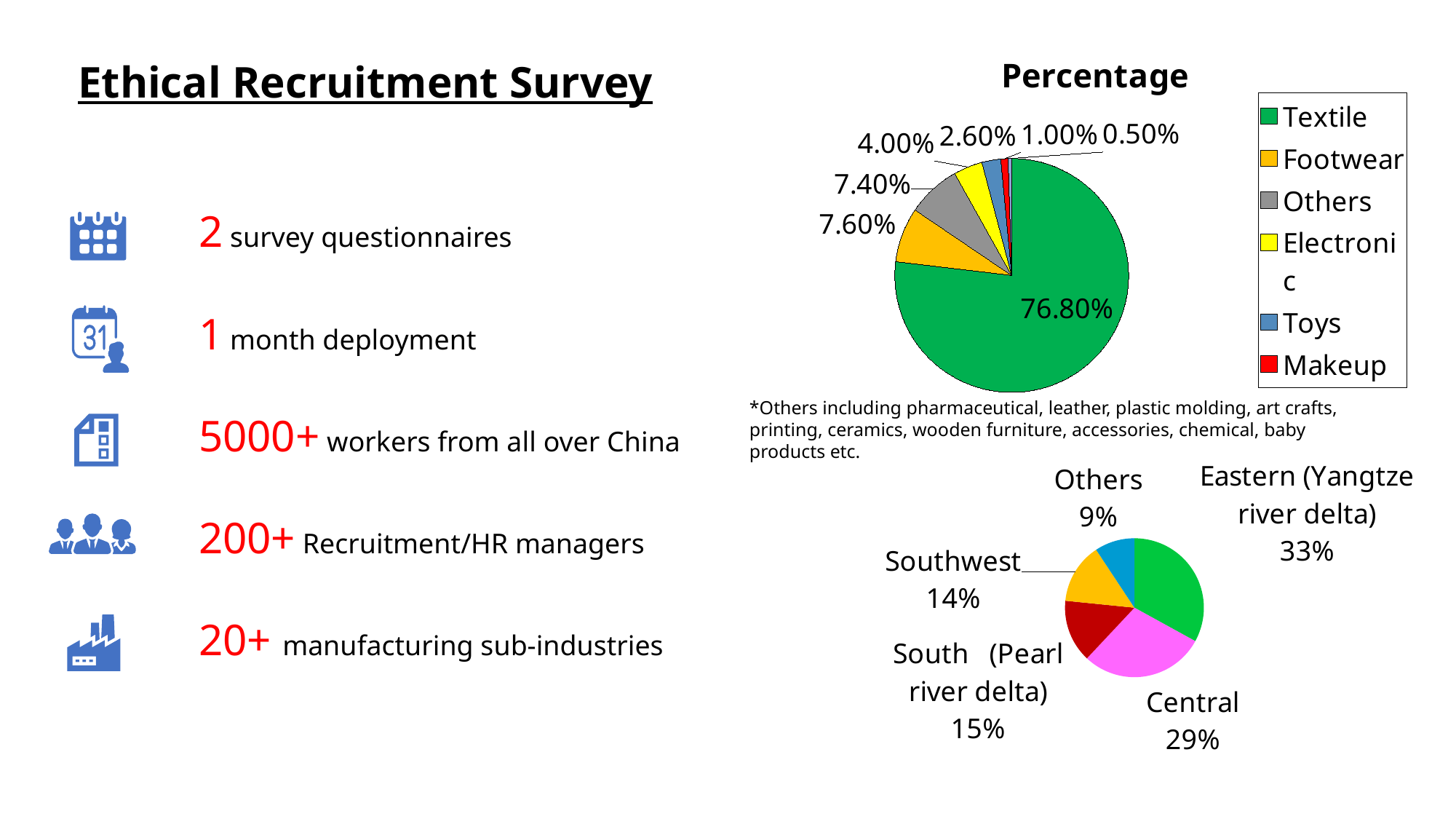
In the bottom-right pie chart of regions, how many slices are there? 5 In the pie chart titled "Percentage", what share does Footwear have? 7.60% In the bottom-right pie chart of regions, what is the difference between the Eastern (Yangtze river delta) share and the Central share? 4% In the bottom-right pie chart of regions, which region has the smallest share? Others In the bottom-right pie chart of regions, what share does Central have? 29% In the pie chart titled "Percentage", how many entries does the legend list? 6 In the pie chart titled "Percentage", what share does Others have? 7.40% In the bottom-right pie chart of regions, what share does Eastern (Yangtze river delta) have? 33% In the pie chart titled "Percentage", what share does Textile have? 76.80% In the pie chart titled "Percentage", what colour is the Textile slice? Green What kind of chart is the chart titled "Percentage"? Pie chart In the pie chart titled "Percentage", which category has the largest slice? Textile